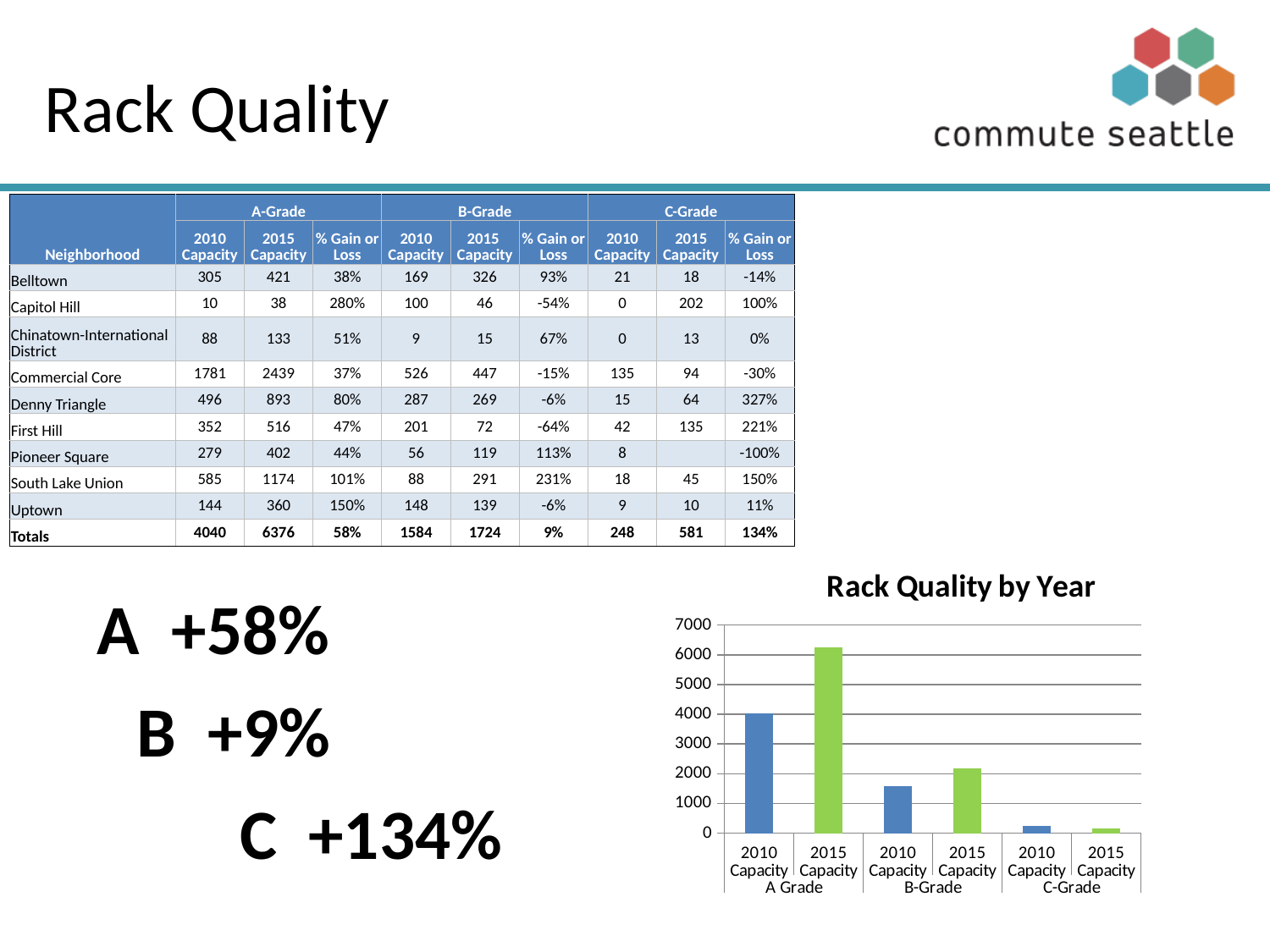
In the 'Rack Quality by Year' chart, which bar is the highest? A Grade 2015 Capacity In the 'Rack Quality by Year' chart, which is larger: A Grade 2010 Capacity or B-Grade 2015 Capacity? A Grade 2010 Capacity How many grade groups are shown along the x axis of the 'Rack Quality by Year' chart? 3 What is the title of the chart on the slide? Rack Quality by Year What kind of chart is the 'Rack Quality by Year' chart? bar chart In the 'Rack Quality by Year' chart, is the value for A Grade 2010 Capacity greater or less than 5000? less In the 'Rack Quality by Year' chart, is the value for A Grade 2015 Capacity greater or less than 6000? greater In the 'Rack Quality by Year' chart, is the value for C-Grade 2010 Capacity greater or less than 1000? less In the 'Rack Quality by Year' chart, which bar is the lowest? C-Grade 2015 Capacity How many bars are plotted in the 'Rack Quality by Year' chart? 6 In the 'Rack Quality by Year' chart, does the A Grade capacity rise or fall from 2010 to 2015? rise